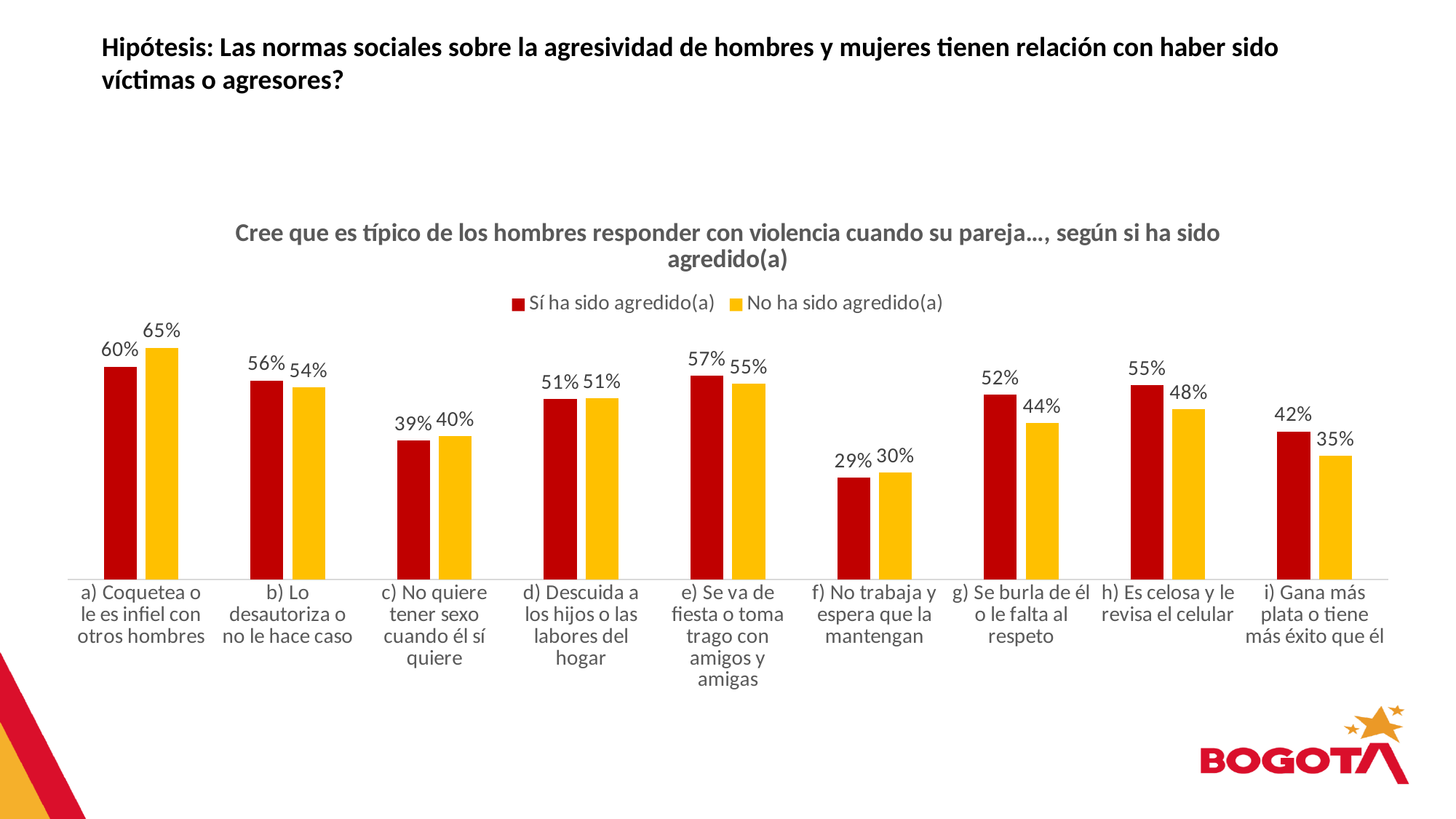
What is the title of the chart? Cree que es típico de los hombres responder con violencia cuando su pareja…, según si ha sido agredido(a) What is the value for 'No ha sido agredido(a)' in category 'i) Gana más plata o tiene más éxito que él'? 35% How many categories are shown on the x axis? 9 In category 'h) Es celosa y le revisa el celular', which series has the larger value: 'Sí ha sido agredido(a)' or 'No ha sido agredido(a)'? Sí ha sido agredido(a) Which category has the lowest value for 'Sí ha sido agredido(a)'? f) No trabaja y espera que la mantengan What kind of chart is shown on the slide? Bar chart What is the value for 'Sí ha sido agredido(a)' in category 'a) Coquetea o le es infiel con otros hombres'? 60% Which colour represents the series 'No ha sido agredido(a)'? Yellow Which category has the highest value for 'No ha sido agredido(a)'? a) Coquetea o le es infiel con otros hombres How many series does the legend list? 2 What is the value for 'No ha sido agredido(a)' in category 'g) Se burla de él o le falta al respeto'? 44% What is the difference between 'Sí ha sido agredido(a)' and 'No ha sido agredido(a)' in category 'g) Se burla de él o le falta al respeto'? 8%